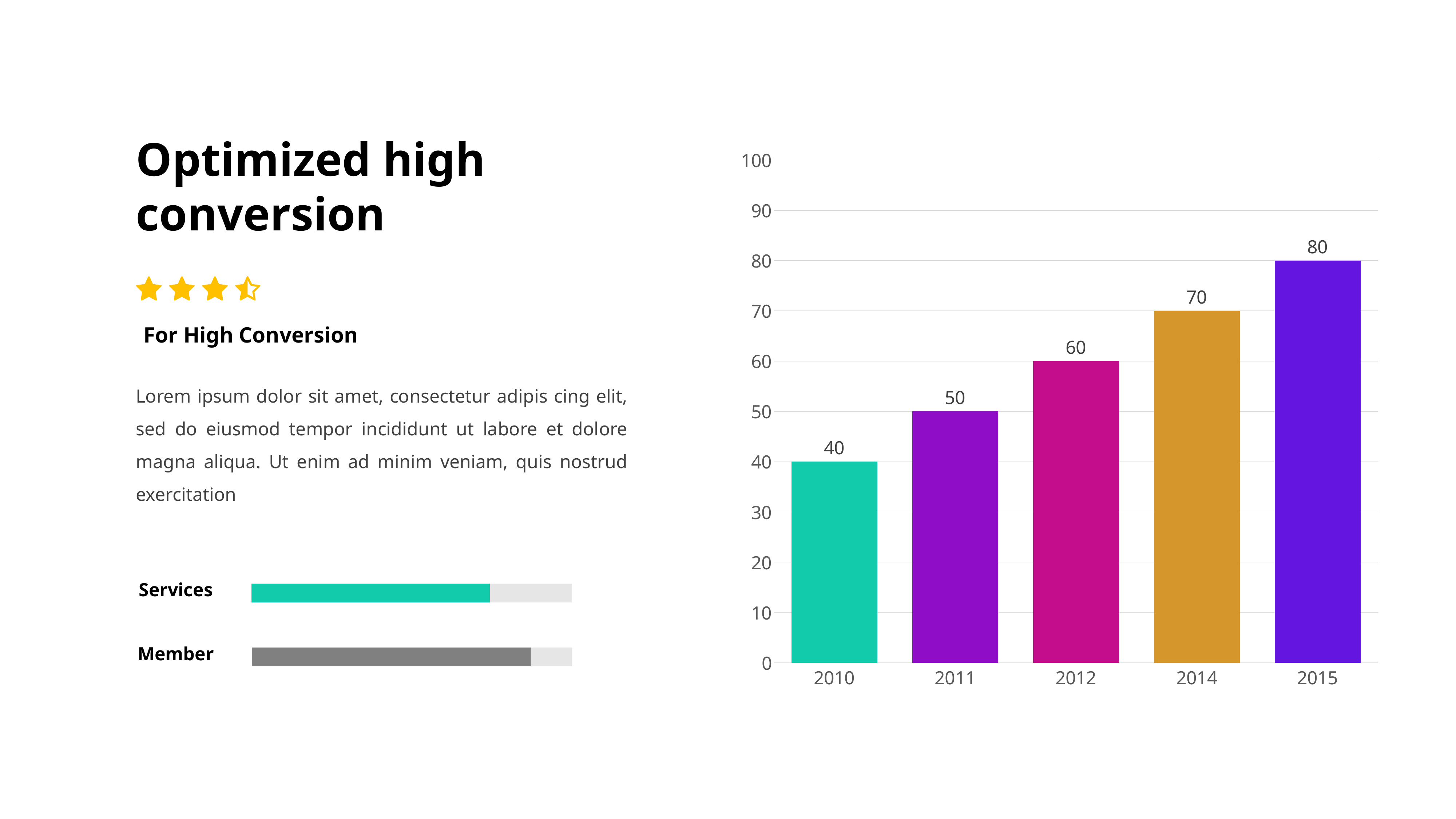
What is the difference between the values for 2015 and 2010? 40 What is the value for 2012? 60 Do the values rise or fall from 2010 to 2015? rise What is the value for 2010? 40 Which is larger, the value for 2011 or the value for 2014? 2014 What is the difference between the values for 2014 and 2011? 20 What kind of chart is shown on the slide? bar chart What is the value for 2015? 80 Is the value for 2012 greater or less than 50? greater How many years are shown on the x axis? 5 Which year has the highest value? 2015 Which year has the lowest value? 2010